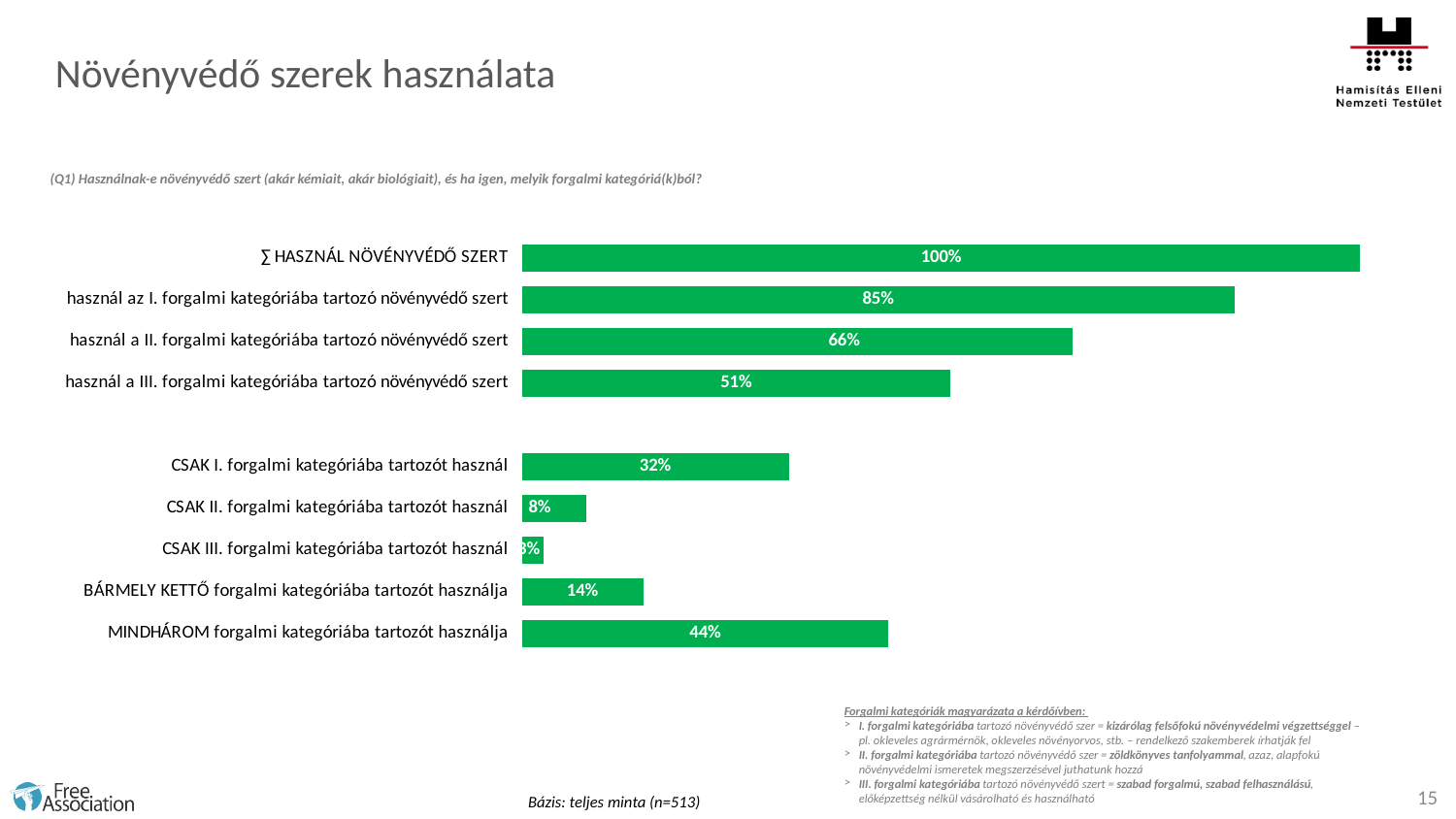
What is the value for "CSAK I. forgalmi kategóriába tartozót használ"? 32% What is the difference between the values for "használ az I. forgalmi kategóriába tartozó növényvédő szert" and "használ a II. forgalmi kategóriába tartozó növényvédő szert"? 19 percentage points Which is larger: the value for "CSAK I. forgalmi kategóriába tartozót használ" or "BÁRMELY KETTŐ forgalmi kategóriába tartozót használja"? CSAK I. forgalmi kategóriába tartozót használ What is the value for "használ az I. forgalmi kategóriába tartozó növényvédő szert"? 85% How many bars are plotted in the chart? 9 Which category has the lowest value? CSAK III. forgalmi kategóriába tartozót használ What is the value for "használ a II. forgalmi kategóriába tartozó növényvédő szert"? 66% What is the title of the slide? Növényvédő szerek használata What is the value for "∑ HASZNÁL NÖVÉNYVÉDŐ SZERT"? 100% What type of chart is shown on the slide? bar chart What is the value for "MINDHÁROM forgalmi kategóriába tartozót használja"? 44% Which category has the highest value? ∑ HASZNÁL NÖVÉNYVÉDŐ SZERT